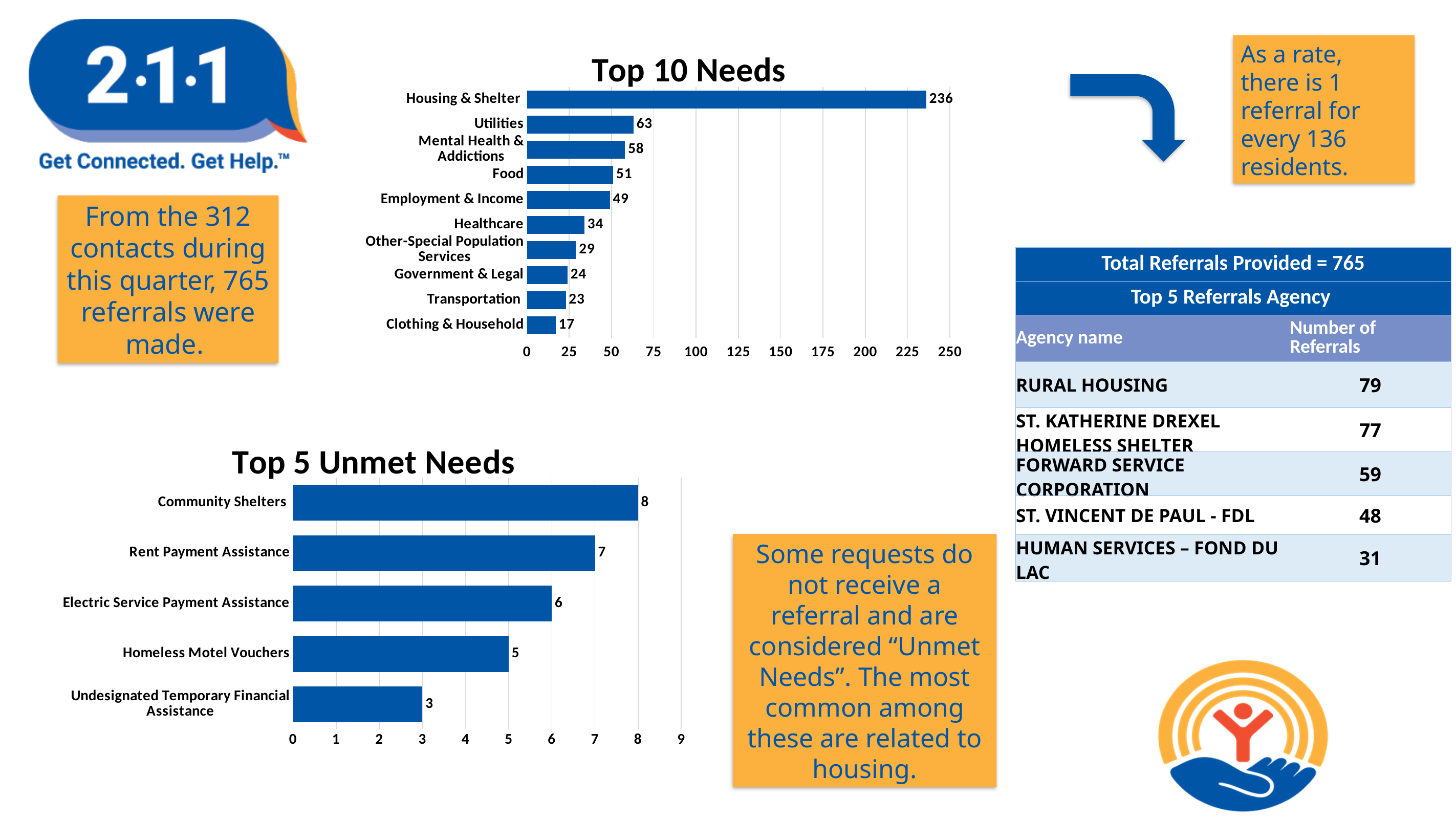
What kind of chart is the Top 10 Needs chart? Bar chart In the Top 5 Unmet Needs chart, which category has the highest value? Community Shelters In the Top 5 Unmet Needs chart, what is the difference between Community Shelters and Undesignated Temporary Financial Assistance? 5 In the Top 10 Needs chart, what is the value for Housing & Shelter? 236 How many categories are shown in the Top 5 Unmet Needs chart? 5 In the Top 5 Unmet Needs chart, what is the value for Rent Payment Assistance? 7 In the Top 10 Needs chart, which category has the lowest value? Clothing & Household How many categories are shown in the Top 10 Needs chart? 10 In the Top 10 Needs chart, what is the value for Employment & Income? 49 In the Top 10 Needs chart, what is the difference between Utilities and Mental Health & Addictions? 5 In the Top 10 Needs chart, which is larger, Healthcare or Government & Legal? Healthcare In the Top 10 Needs chart, is the value for Food greater or less than 50? greater